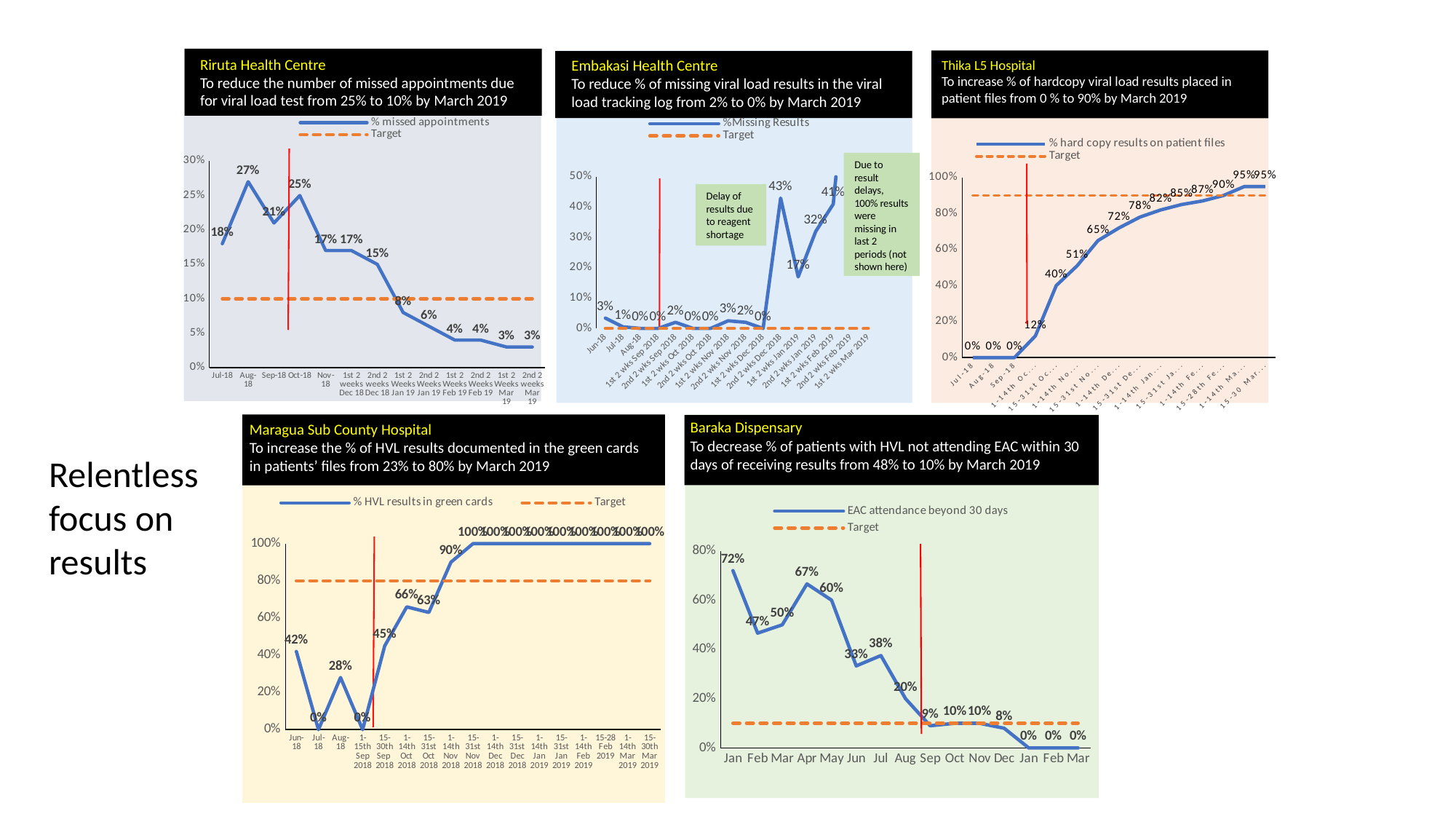
In the Maragua Sub County Hospital chart, what is the % HVL results in green cards for Jun-18? 42% In the Baraka Dispensary chart, which is larger, the value for Jun or the value for Jul? Jul In the Thika L5 Hospital chart, do the values generally rise or fall from left to right? rise In the Maragua Sub County Hospital chart, what is the value for 1-14th Nov 2018? 90% In the Riruta Health Centre chart, what is the % missed appointments value for Aug-18? 27% In the Riruta Health Centre chart, how many series does the legend list? 2 What kind of chart is the Baraka Dispensary chart? line chart In the Embakasi Health Centre chart, what is the % missing results value for the 2nd 2 wks Dec 2018? 43% In the Thika L5 Hospital chart, what is the % hard copy results on patient files for Aug-18? 0% In the Riruta Health Centre chart, what is the difference between the Oct-18 value and the Nov-18 value? 8 percentage points In the Riruta Health Centre chart, which period has the highest % missed appointments? Aug-18 In the Baraka Dispensary chart, what is the EAC attendance beyond 30 days value for Apr? 67%